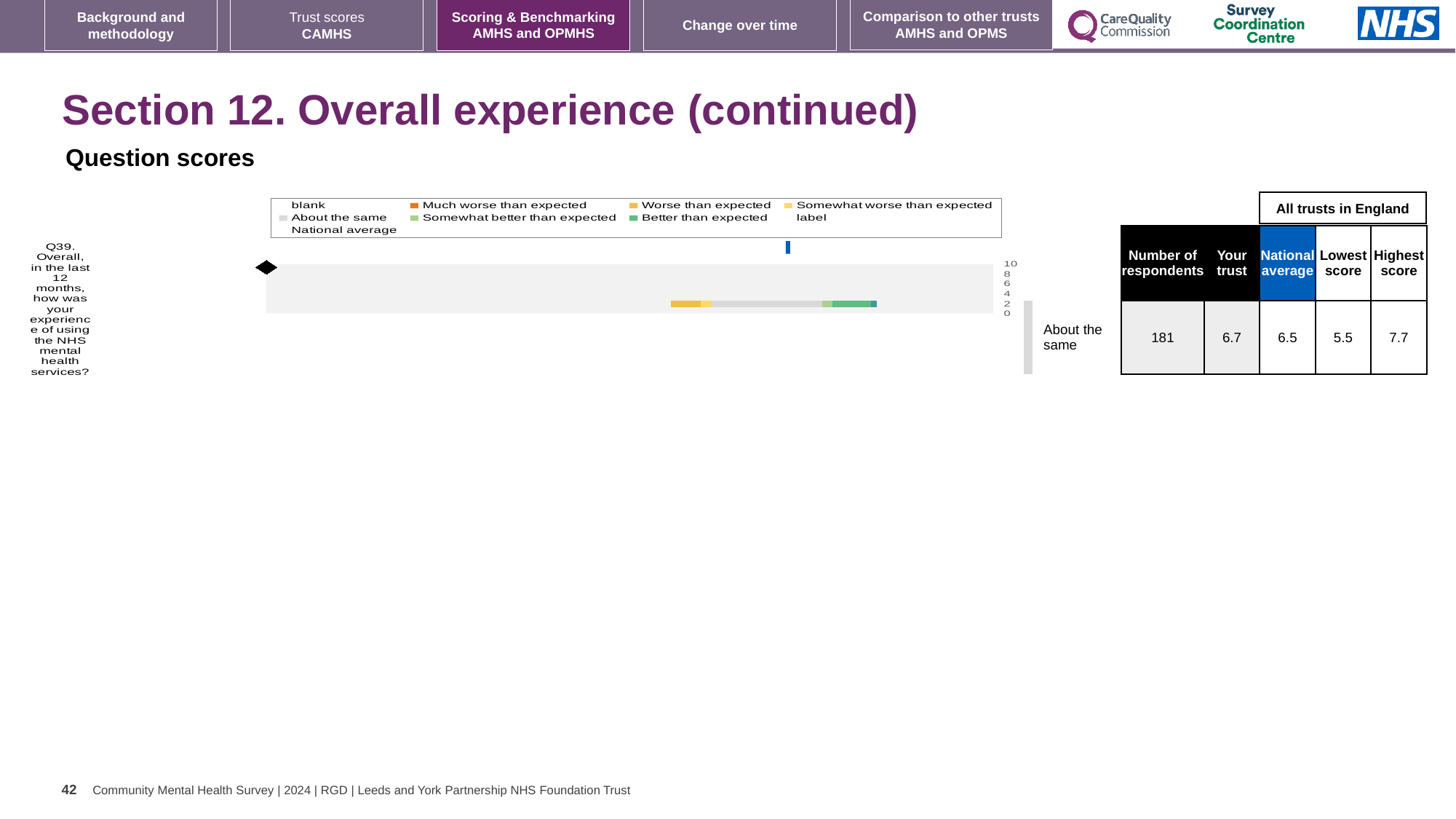
Which is larger for Q39, the 'Your trust' score or the national average? Your trust What is the highest score among all trusts in England for Q39? 7.7 What is the national average score for Q39? 6.5 What is the 'Your trust' score for Q39? 6.7 What is the difference between the highest score and the lowest score for Q39? 2.2 How many survey questions are plotted in the chart? 1 What kind of chart is shown for Q39 on this slide? bar chart Is the 'Your trust' score for Q39 greater or less than 6? greater What is the lowest score among all trusts in England for Q39? 5.5 Which question number is plotted in the chart? Q39 How many respondents answered Q39? 181 What benchmark category is shown next to the chart for Q39? About the same